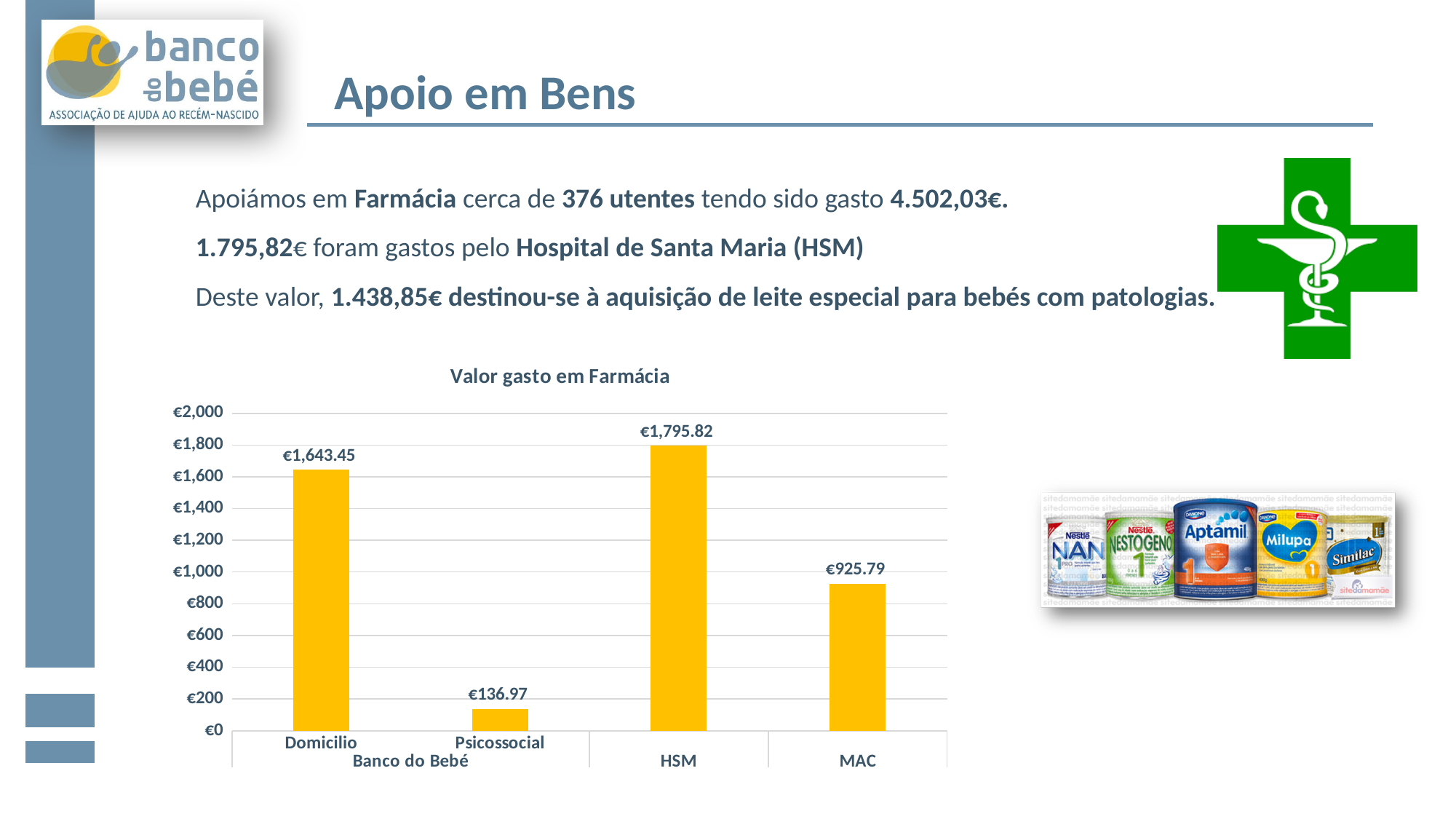
How many bars are plotted in the chart? 4 What is the difference between the values for HSM and Domicilio? €152.37 What is the value for Psicossocial in the chart? €136.97 Which is larger, the value for Domicilio or the value for MAC? Domicilio Which category has the highest value in the chart? HSM What is the value for Domicilio in the chart? €1,643.45 What is the difference between the values for HSM and MAC? €870.03 What is the title of the chart? Valor gasto em Farmácia What is the value for MAC in the chart? €925.79 What is the value for HSM in the chart? €1,795.82 Is the value for MAC greater or less than €1,000? less Which category has the lowest value in the chart? Psicossocial